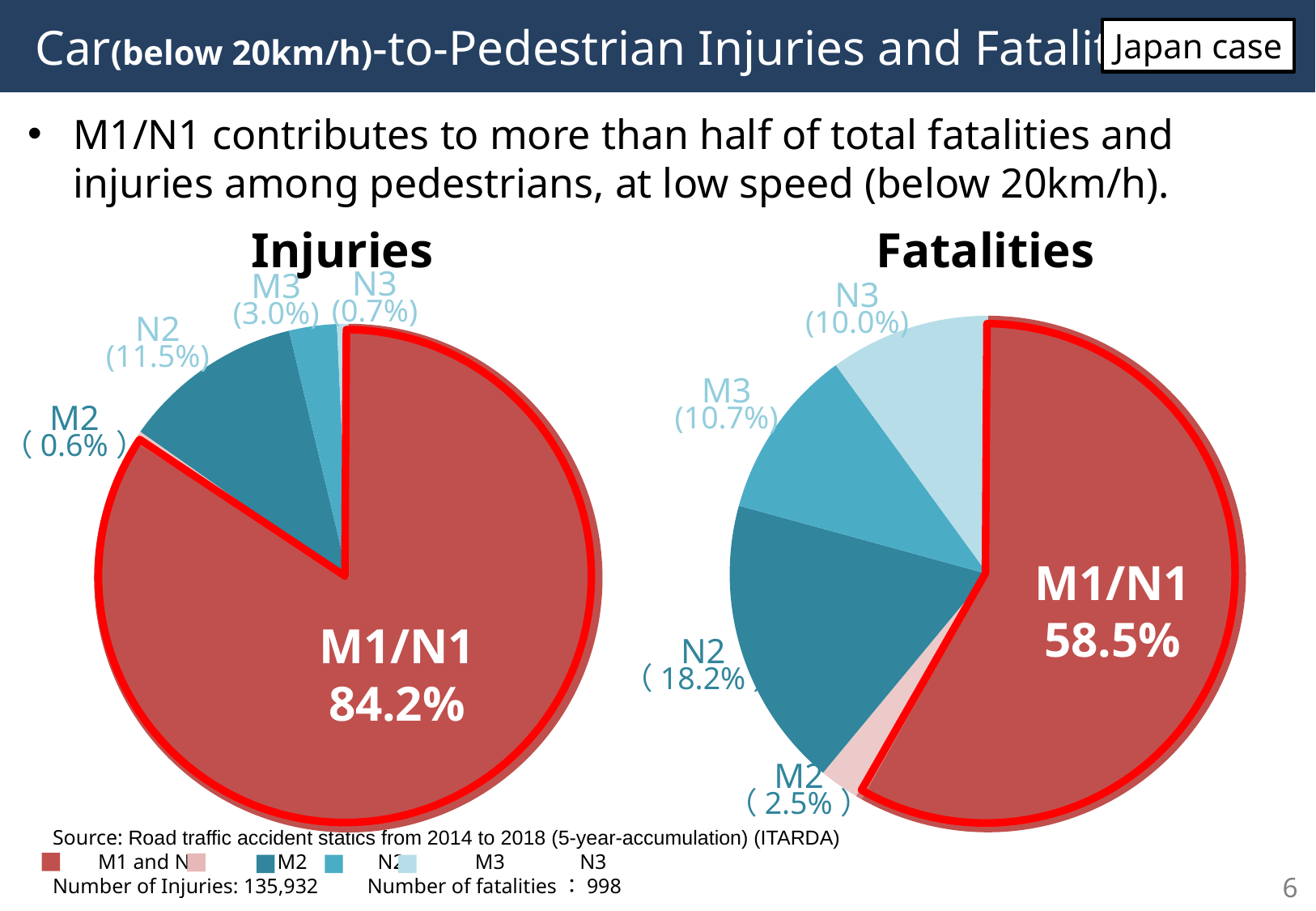
In the Fatalities pie chart, what share does M1/N1 have? 58.5% In the Fatalities pie chart, which category has the smallest share? M2 How many slices does the Fatalities pie chart have? 5 In the Injuries pie chart, what share does M1/N1 have? 84.2% In the Fatalities pie chart, what is the share for M3? 10.7% In the Injuries pie chart, what is the share for N2? 11.5% In the Fatalities pie chart, which category has the largest share? M1/N1 In the Fatalities pie chart, what is the difference between the N2 share and the M3 share? 7.5% What is the title of the chart on the right side of the slide? Fatalities What type of chart is used for Injuries? Pie chart In the Injuries pie chart, which is larger, the share for M3 or the share for N3? M3 In the Injuries pie chart, which category has the smallest share? M2